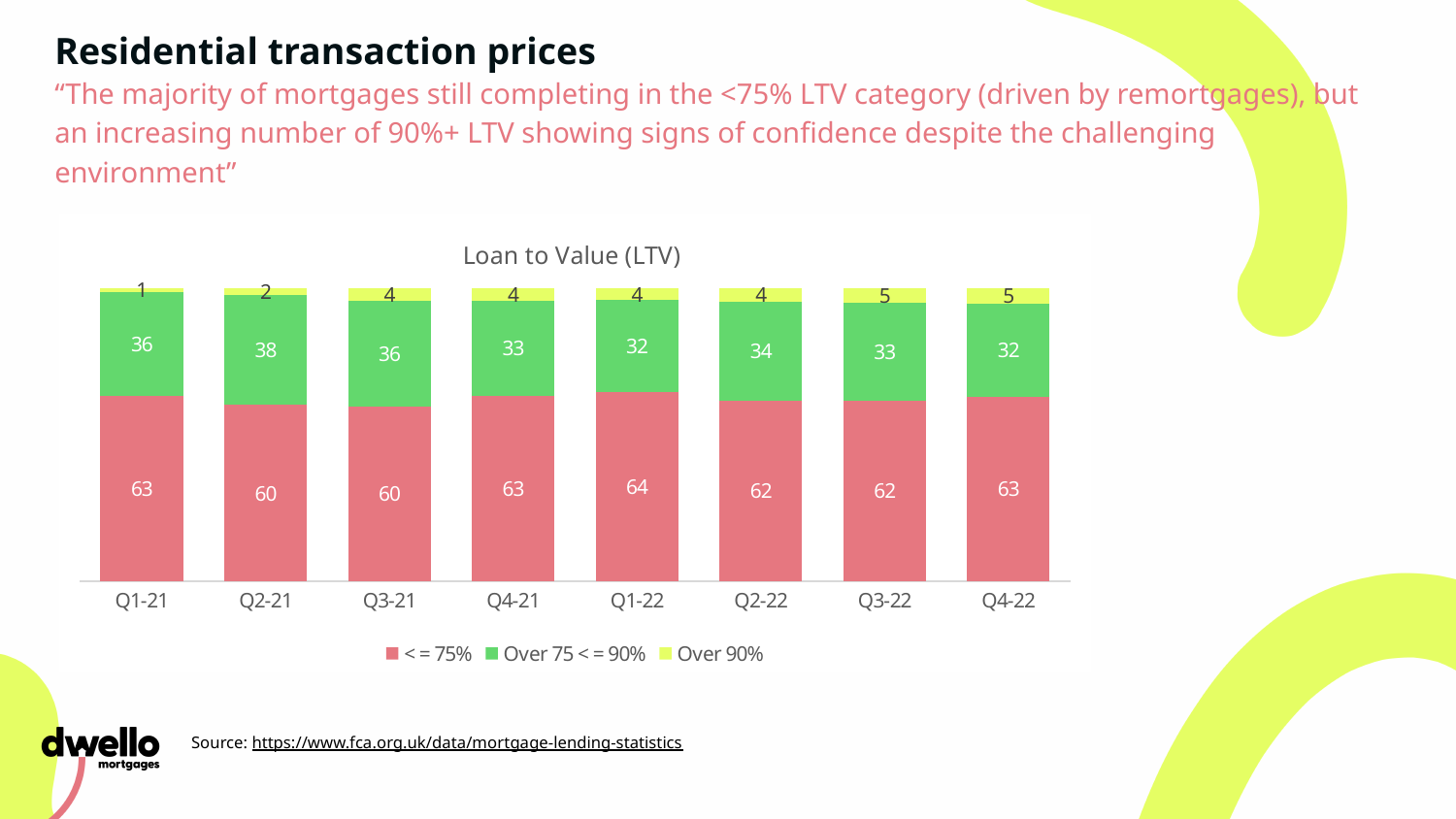
What is the title of the chart? Loan to Value (LTV) What is the value for <= 75% in Q1-22? 64 In which quarter is the <= 75% value highest? Q1-22 What is the total of the stacked bar for Q3-22? 100 How many quarters are shown on the x axis? 8 What is the value for Over 75 <= 90% in Q2-21? 38 What is the value for Over 90% in Q4-22? 5 What kind of chart is shown? Stacked bar chart What is the difference between the <= 75% values for Q1-22 and Q2-21? 4 In which quarter is the Over 90% value lowest? Q1-21 How many series does the legend list? 3 Which is larger, the Over 75 <= 90% value in Q2-22 or in Q4-22? Q2-22